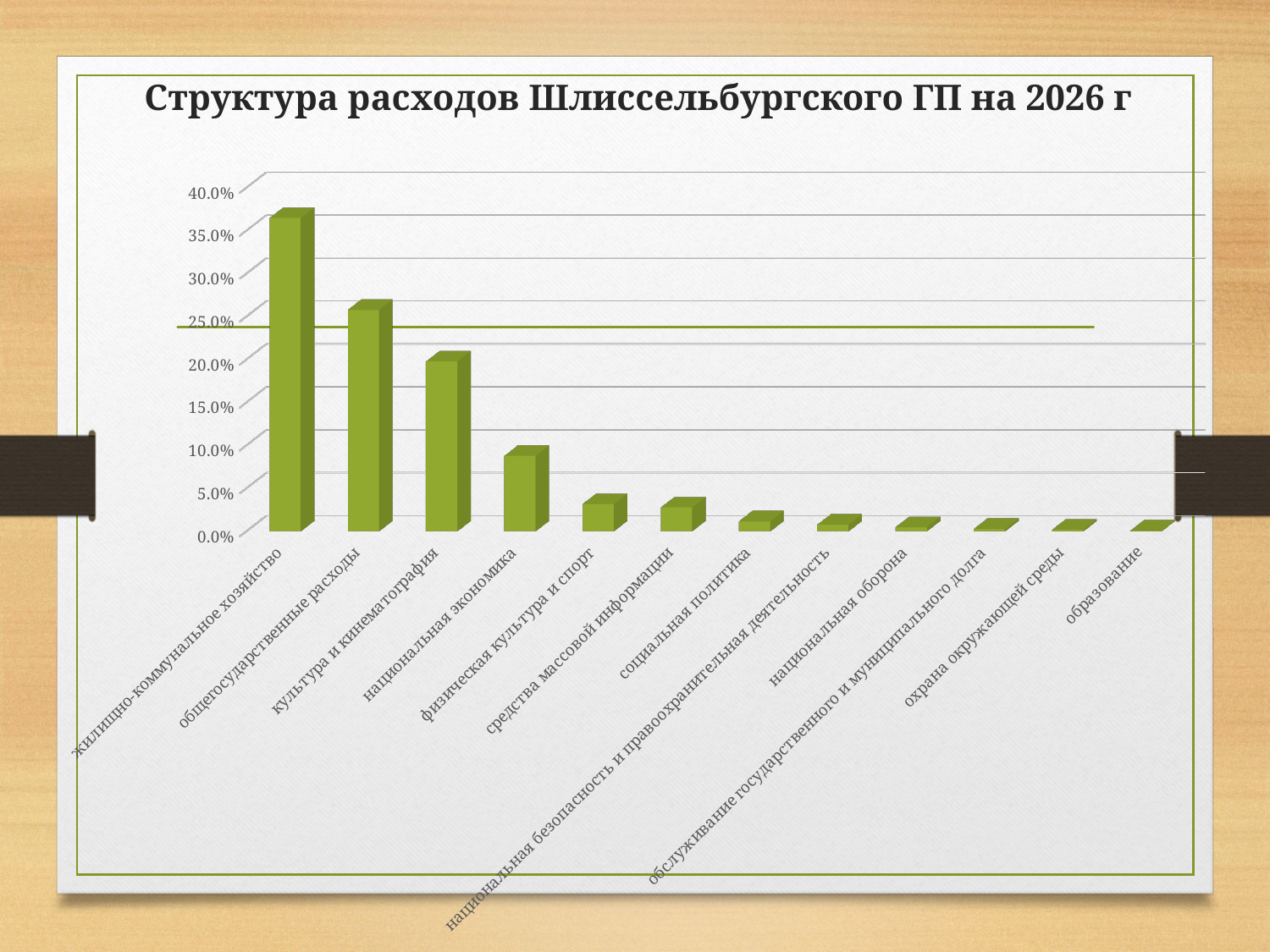
What kind of chart is shown on the slide? bar chart Which is larger, the value for жилищно-коммунальное хозяйство or the value for общегосударственные расходы? жилищно-коммунальное хозяйство What is the title of the chart? Структура расходов Шлиссельбургского ГП на 2026 г Is the value for физическая культура и спорт greater or less than 5.0%? less Which is larger, the value for культура и кинематография or the value for национальная экономика? культура и кинематография Is the value for национальная экономика greater or less than 10.0%? less Is the value for общегосударственные расходы greater or less than 20.0%? greater Do the values rise or fall from left to right along the x axis? fall How many categories are plotted on the x axis? 12 Which category has the highest value? жилищно-коммунальное хозяйство